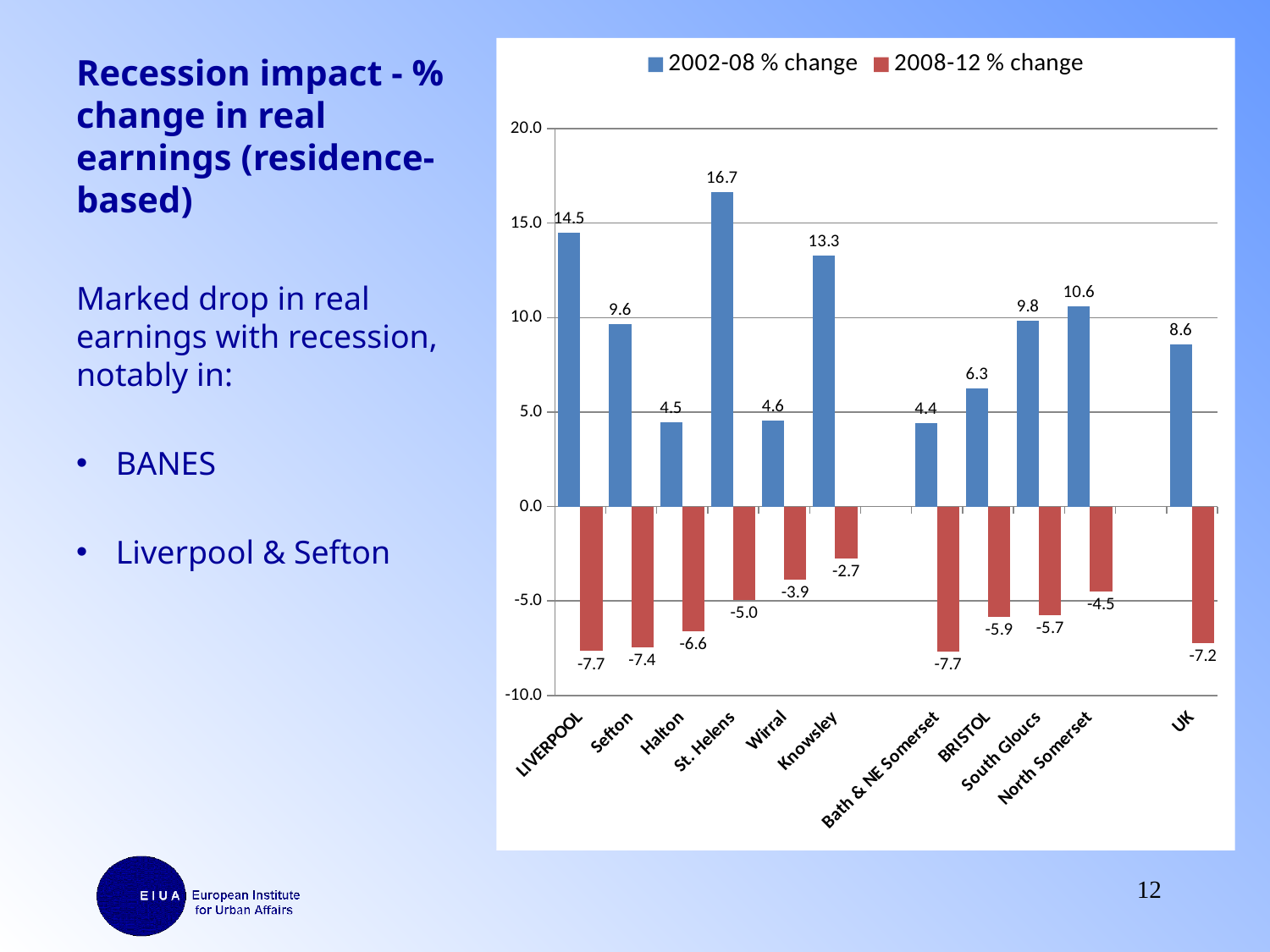
What kind of chart is shown on the slide? Bar chart Which category has the highest 2002-08 % change? St. Helens How many series does the chart legend list? 2 What is the 2002-08 % change value for St. Helens? 16.7 Which has a larger 2002-08 % change, Sefton or South Gloucs? South Gloucs Is the 2002-08 % change value for Knowsley greater or less than 10.0? greater What is the difference between the 2002-08 % change for St. Helens and for LIVERPOOL? 2.2 What is the 2008-12 % change value for Sefton? -7.4 Which category has the smallest decline (highest value) in the 2008-12 % change series? Knowsley How many categories are shown on the x axis of the chart? 11 What is the 2008-12 % change value for Knowsley? -2.7 What is the 2002-08 % change value for the UK? 8.6